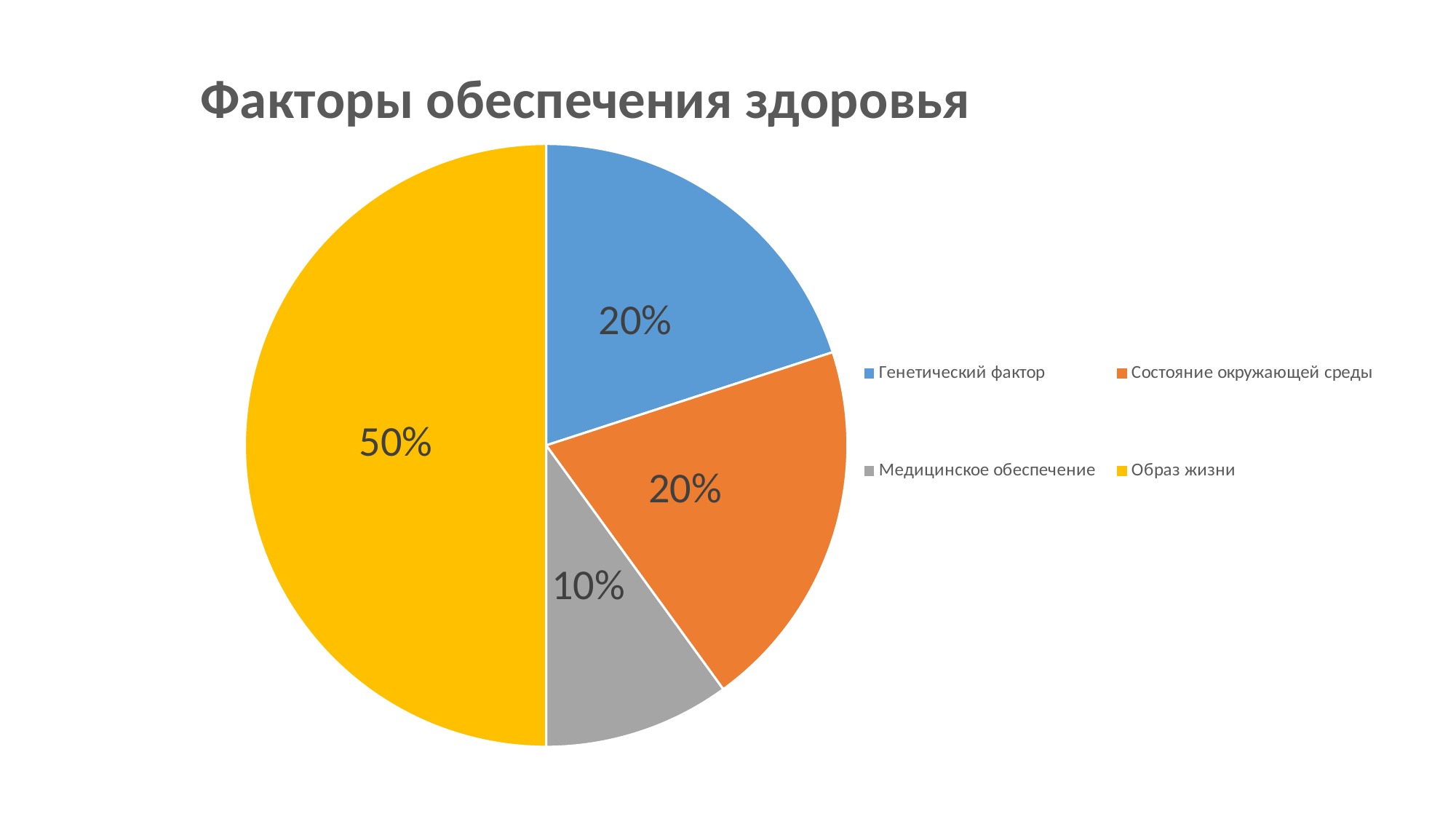
What is the difference between the shares of Образ жизни and Медицинское обеспечение? 40% What kind of chart is shown on the slide? Pie chart What is the value for Состояние окружающей среды? 20% What is the value for Медицинское обеспечение? 10% What is the value for Генетический фактор? 20% Which is larger, the share for Генетический фактор or the share for Медицинское обеспечение? Генетический фактор What is the title of the chart? Факторы обеспечения здоровья Which category has the smallest share of the pie? Медицинское обеспечение What colour is the slice for Образ жизни? Yellow How many categories does the pie chart have? 4 Which category has the largest share of the pie? Образ жизни What share of the pie does Образ жизни take? 50%